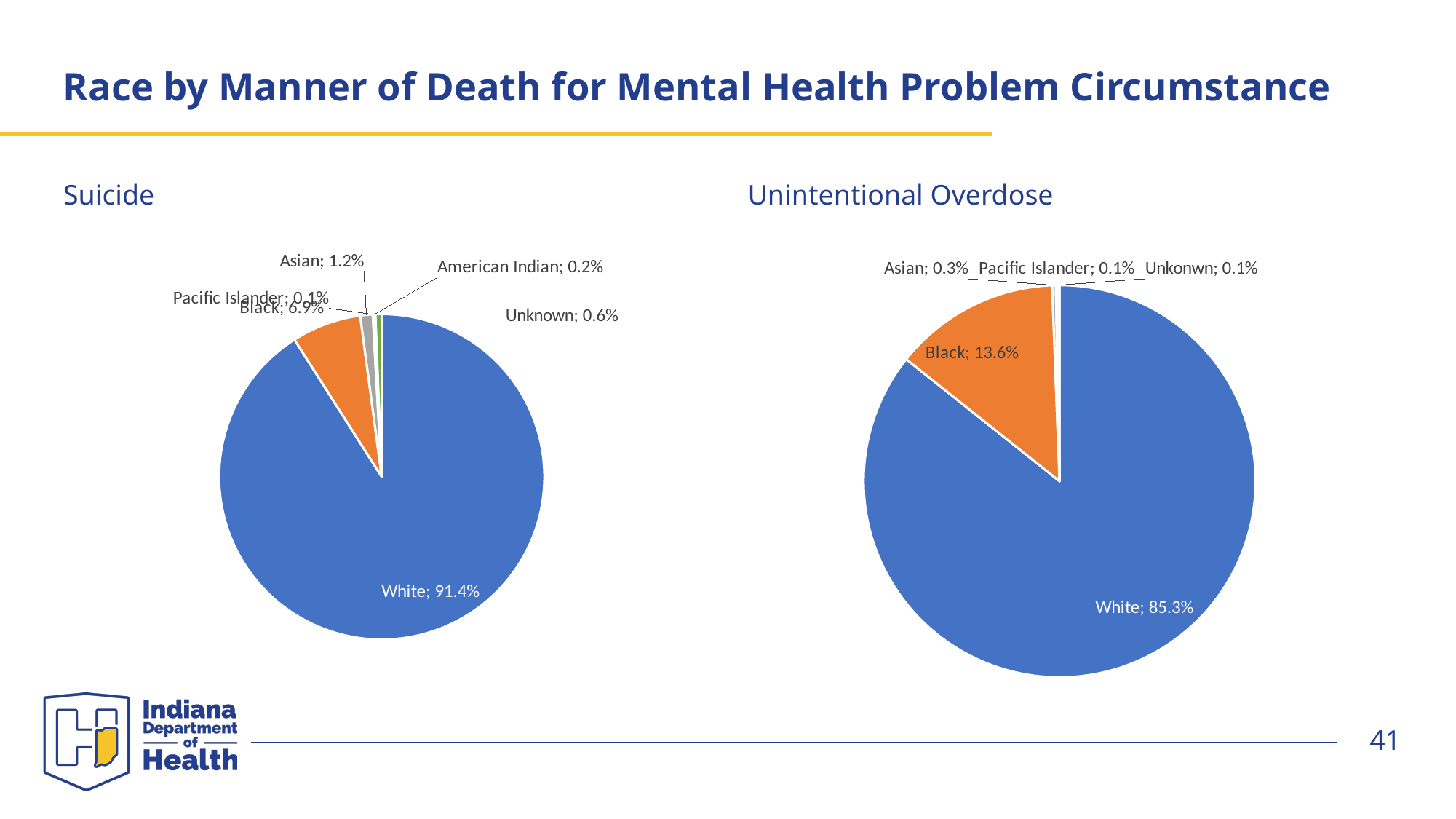
In the Suicide chart, what share is labelled for Asian? 1.2% In the Unintentional Overdose chart, what share is labelled for Black? 13.6% In the Unintentional Overdose chart, what share is labelled for Asian? 0.3% In the Suicide chart, what share is labelled for American Indian? 0.2% In the Unintentional Overdose chart, which race has the largest share? White In the Suicide chart, what share is labelled for Black? 6.9% In the Unintentional Overdose chart, what share is labelled for White? 85.3% In the Suicide chart, what share is labelled for White? 91.4% What is the difference between the Black share in the Unintentional Overdose chart and the Black share in the Suicide chart? 6.7% In the Suicide chart, which race has the smallest share? Pacific Islander What kind of charts are shown on the slide? Pie charts How many slices does the Suicide pie chart have? 6